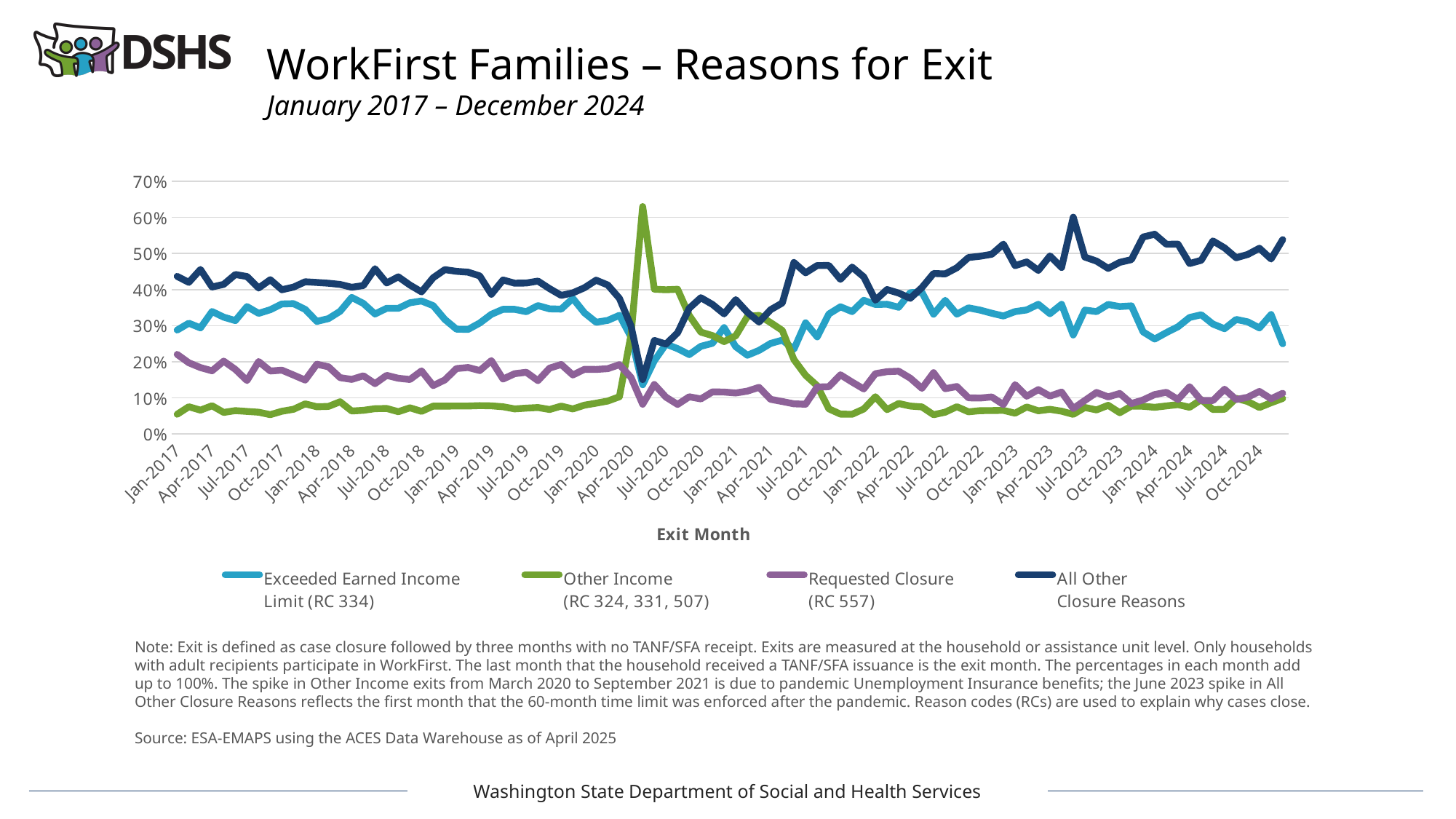
In Jan-2017, which is higher: All Other Closure Reasons or Exceeded Earned Income Limit (RC 334)? All Other Closure Reasons What kind of chart is shown on the slide? Line chart What is the label of the x axis? Exit Month Which series has the lowest value in Jan-2017? Other Income (RC 324, 331, 507) How many series does the legend list? 4 Which series has the highest value at the end of the chart in late 2024? All Other Closure Reasons Is the value for Requested Closure (RC 557) in Jan-2017 greater or less than 30%? less Is the value for Other Income (RC 324, 331, 507) in Jan-2017 greater or less than 10%? less Does the Requested Closure (RC 557) line rise or fall overall from Jan-2017 to the end of 2024? fall What is the title of the chart on the slide? WorkFirst Families – Reasons for Exit Is the peak value of the Other Income (RC 324, 331, 507) line greater or less than 60%? greater